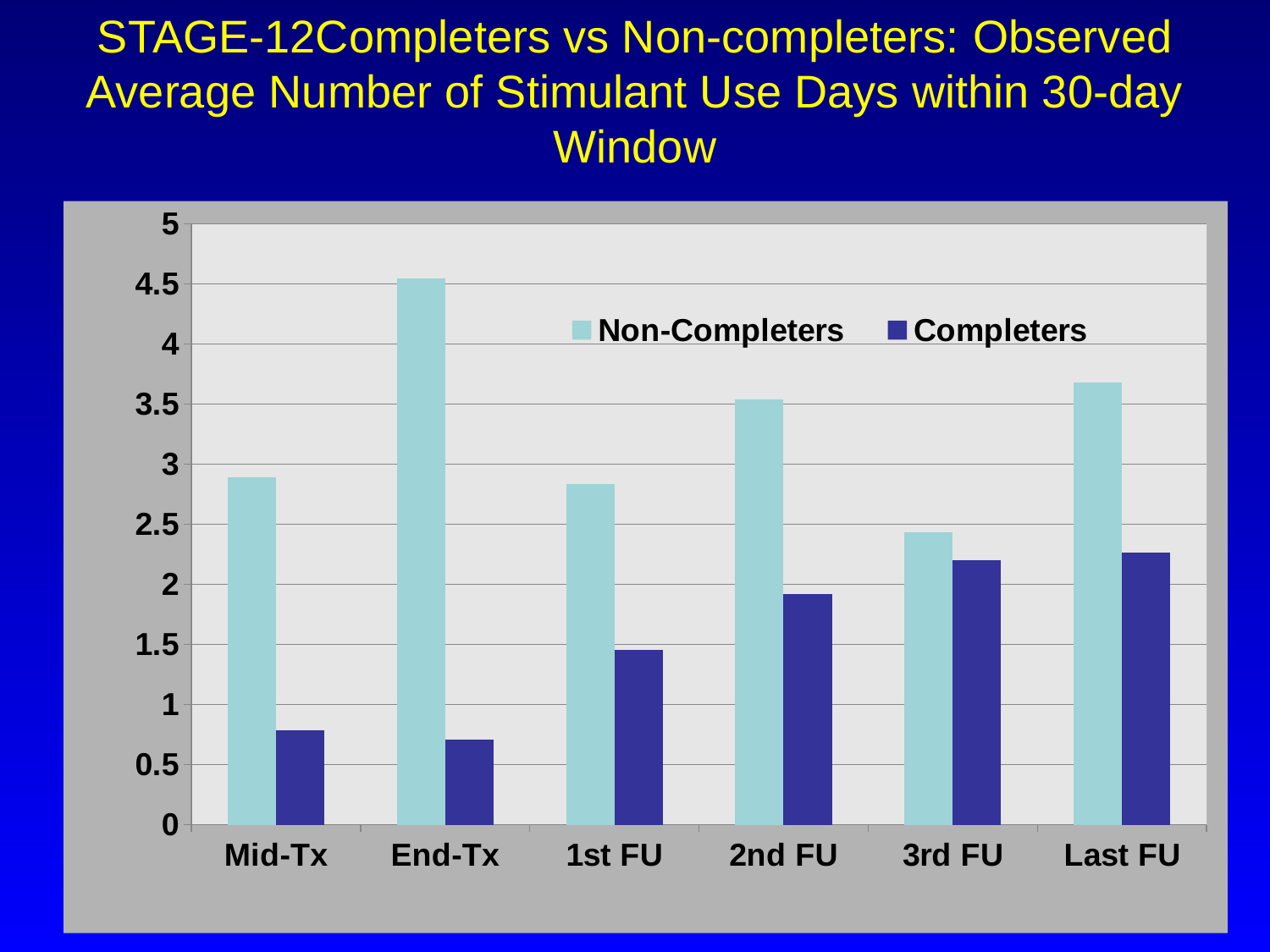
How many series does the legend list? 2 Which colour represents the Non-Completers series? light blue At which time point is the Non-Completers value highest? End-Tx What kind of chart is shown on the slide? bar chart Is the Non-Completers value at 3rd FU greater or less than 3? less Is the Completers value at Mid-Tx greater or less than 1? less Is the Completers value at 3rd FU greater or less than 2? greater For Completers, which is larger, the value at 1st FU or at 2nd FU? 2nd FU At Mid-Tx, which series has the larger value, Non-Completers or Completers? Non-Completers At which time point is the Non-Completers value lowest? 3rd FU How many time-point categories are shown on the x axis? 6